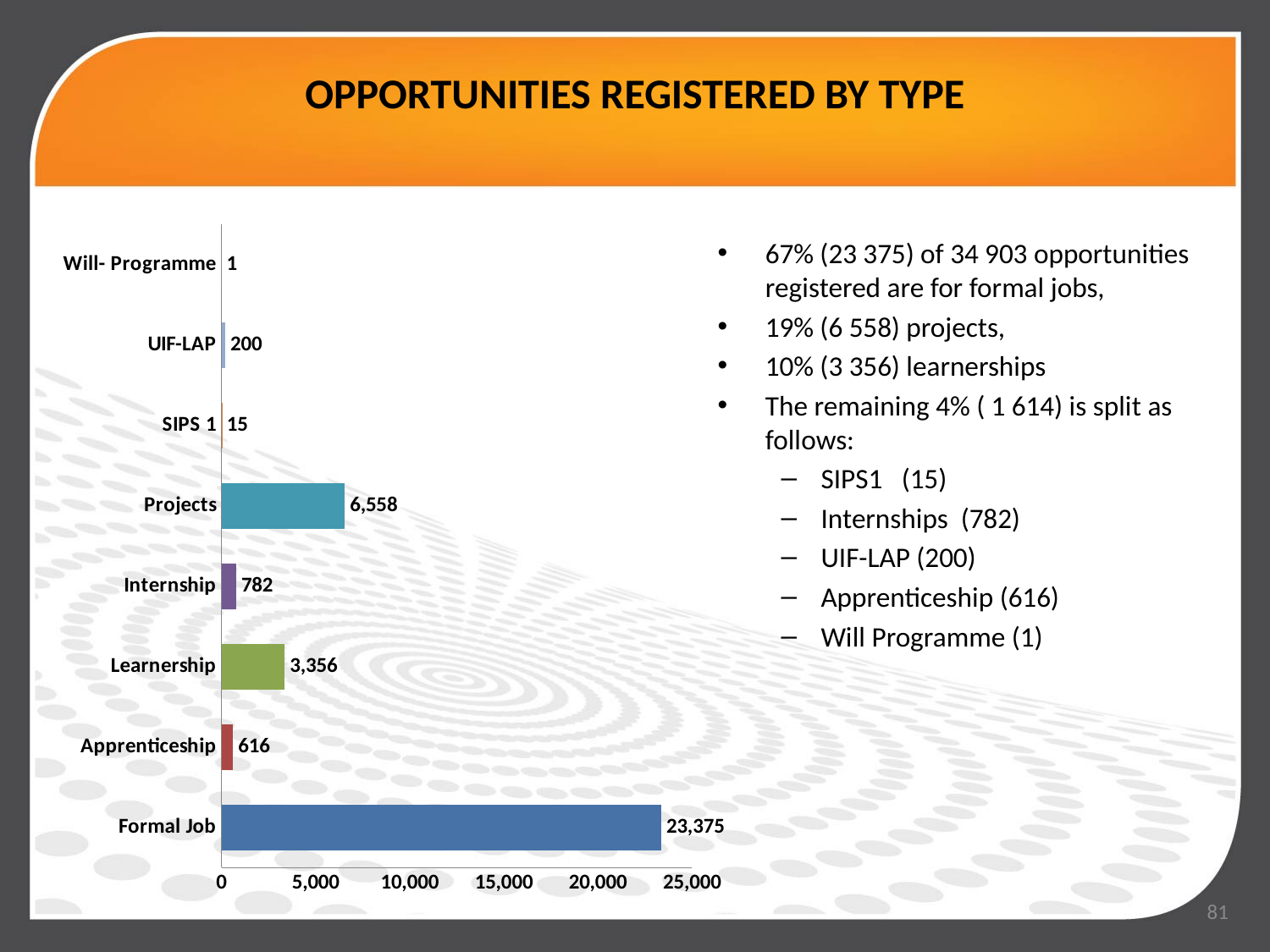
Is the value for Projects greater or less than 5,000? greater What value is shown for Learnership? 3,356 What value is shown for UIF-LAP? 200 What value is shown for Formal Job? 23,375 What is the title of the slide containing the chart? OPPORTUNITIES REGISTERED BY TYPE What kind of chart is shown on the slide? bar chart What is the difference between the values for Formal Job and Projects? 16,817 Which is larger, the value for Internship or the value for Apprenticeship? Internship How many categories are shown in the chart? 8 Which category has the lowest value? Will- Programme What is the difference between the values for Projects and Learnership? 3,202 Which category has the highest value? Formal Job